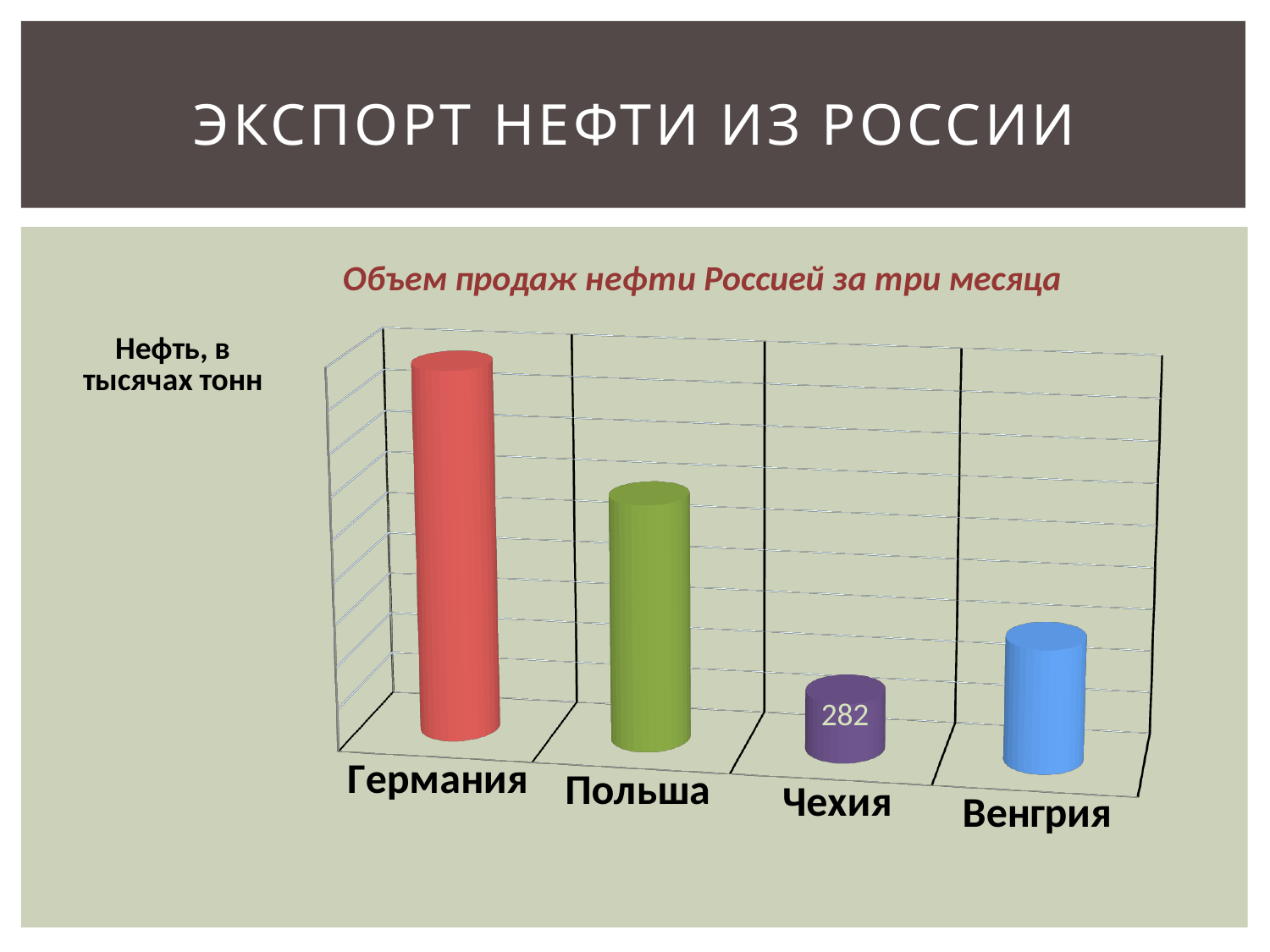
Which country has the highest bar? Германия Which is larger, the value for Польша or the value for Венгрия? Польша Do the values rise or fall from Германия to Чехия? Fall Which country has the lowest bar? Чехия How many countries are shown on the chart? 4 What is the value for Чехия? 282 Which is larger, the value for Германия or the value for Польша? Германия What kind of chart is shown on the slide? Bar chart Which is larger, the value for Венгрия or the value for Чехия? Венгрия What is the title of the chart? Объем продаж нефти Россией за три месяца In what units are the values on the chart measured? Тысячи тонн (thousands of tonnes)